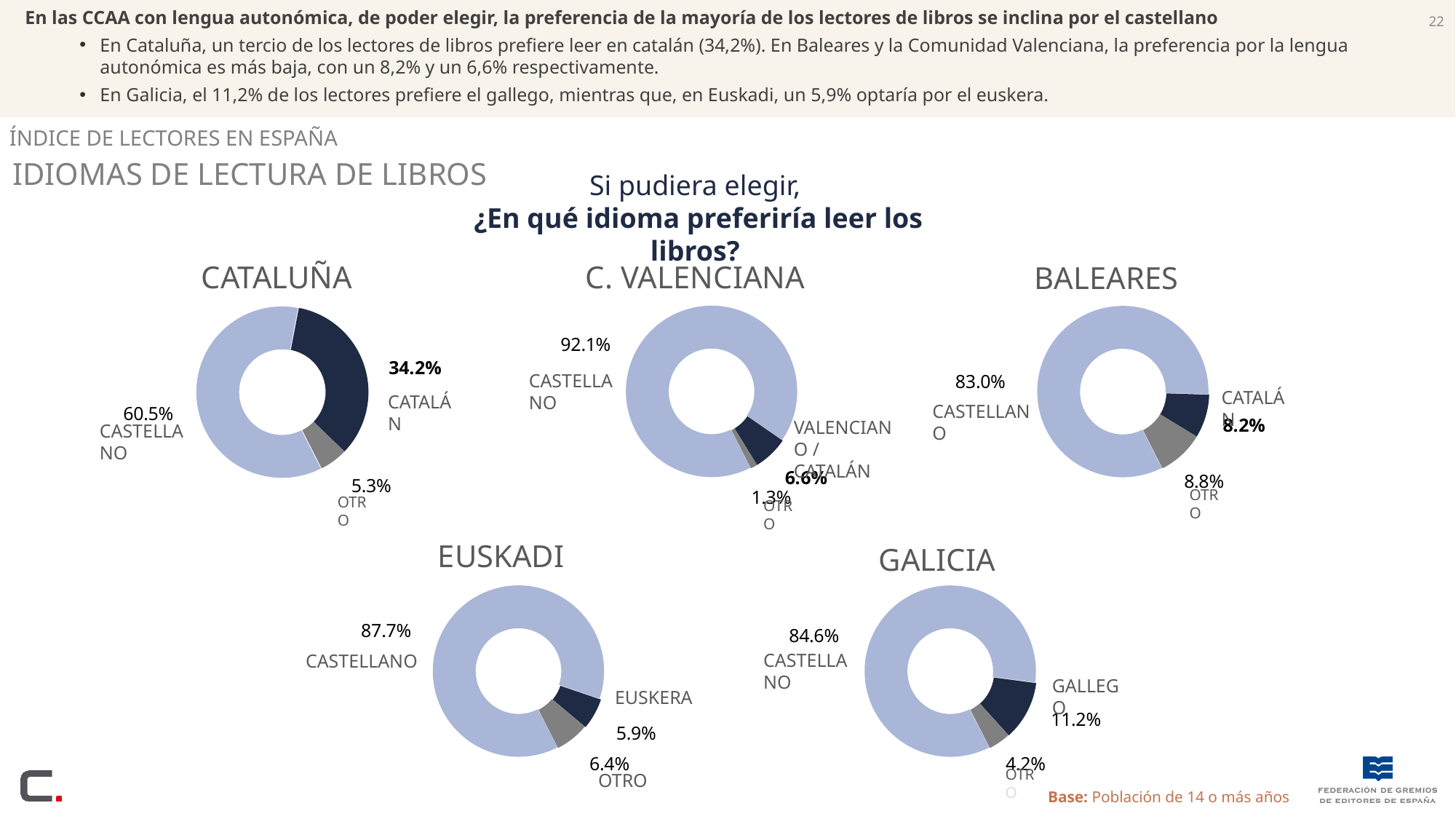
In the EUSKADI chart, what percentage of readers prefer EUSKERA? 5.9% In the C. VALENCIANA chart, what is the value for VALENCIANO / CATALÁN? 6.6% In the BALEARES chart, what is the value for OTRO? 8.8% In the GALICIA chart, which category has the largest share? CASTELLANO What type of chart is used for the CATALUÑA data? Donut (pie) chart In the CATALUÑA chart, what is the difference between the CASTELLANO and CATALÁN shares? 26.3% In the CATALUÑA chart, what percentage of readers prefer CATALÁN? 34.2% How many categories does the EUSKADI chart show? 3 In the CATALUÑA chart, what percentage corresponds to CASTELLANO? 60.5% In the C. VALENCIANA chart, which category has the smallest share? OTRO In the GALICIA chart, what is the value for GALLEGO? 11.2% In the BALEARES chart, which is larger, the share for CATALÁN or the share for OTRO? OTRO